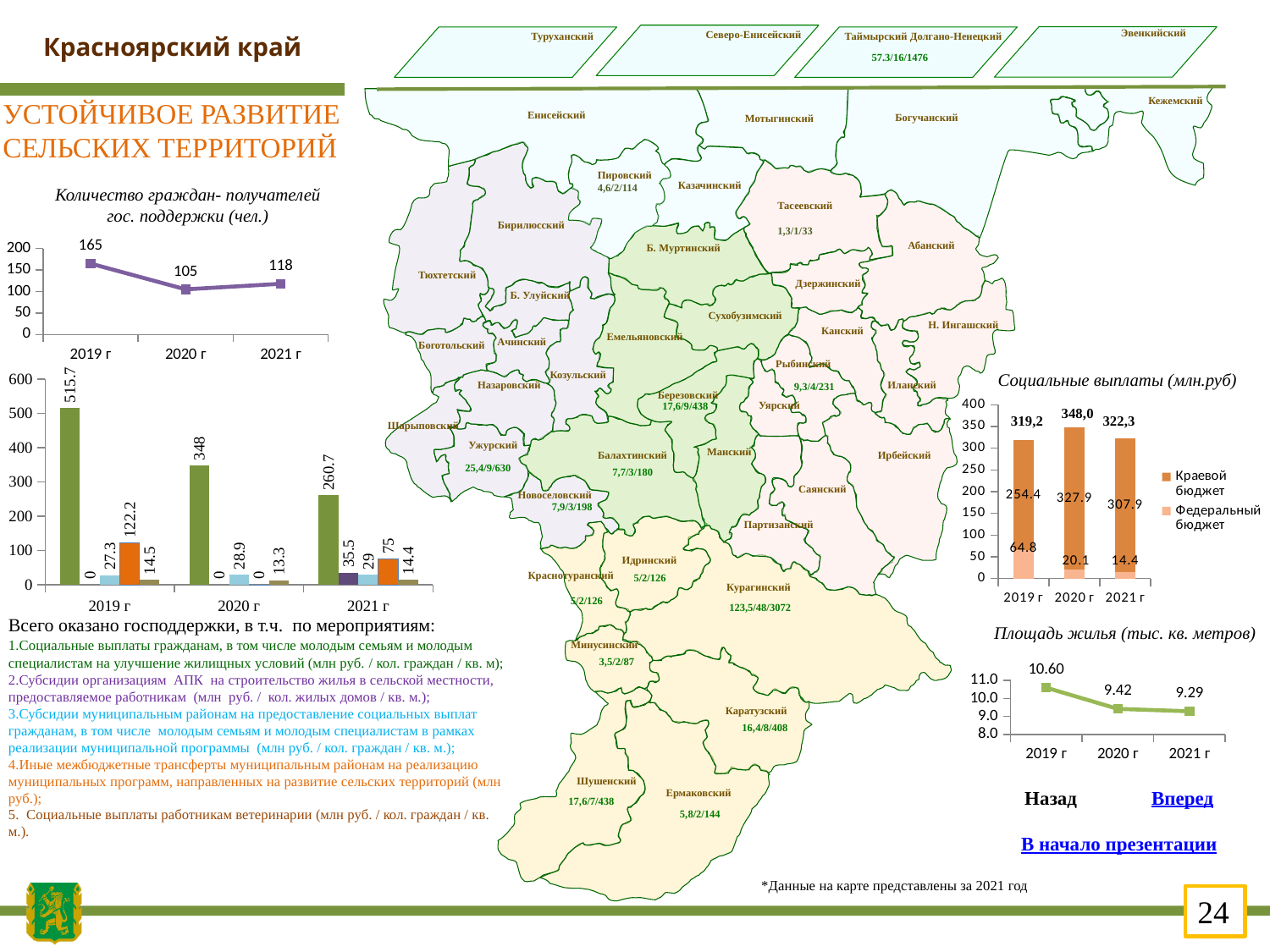
On the chart 'Социальные выплаты (млн.руб)', what is the total of the stacked bar for 2021 г? 322,3 On the chart 'Социальные выплаты (млн.руб)', what is the value of Краевой бюджет for 2020 г? 327.9 On the chart 'Площадь жилья (тыс. кв. метров)', what is the value for 2020 г? 9.42 On the chart 'Площадь жилья (тыс. кв. метров)', which year has the highest value? 2019 г On the chart 'Количество граждан- получателей гос. поддержки (чел.)', what is the difference between the 2019 г and 2021 г values? 47 On the chart 'Количество граждан- получателей гос. поддержки (чел.)', what is the value for 2019 г? 165 On the chart 'Количество граждан- получателей гос. поддержки (чел.)', which year has the lowest value? 2020 г On the bar chart at the lower left of the slide, what is the value of the tallest (green) bar for 2021 г? 260.7 What kind of chart is 'Количество граждан- получателей гос. поддержки (чел.)'? line chart On the chart 'Социальные выплаты (млн.руб)', does Федеральный бюджет rise or fall from 2019 г to 2021 г? fall On the chart 'Социальные выплаты (млн.руб)', what is the value of Федеральный бюджет for 2019 г? 64.8 How many series does the legend of the chart 'Социальные выплаты (млн.руб)' list? 2